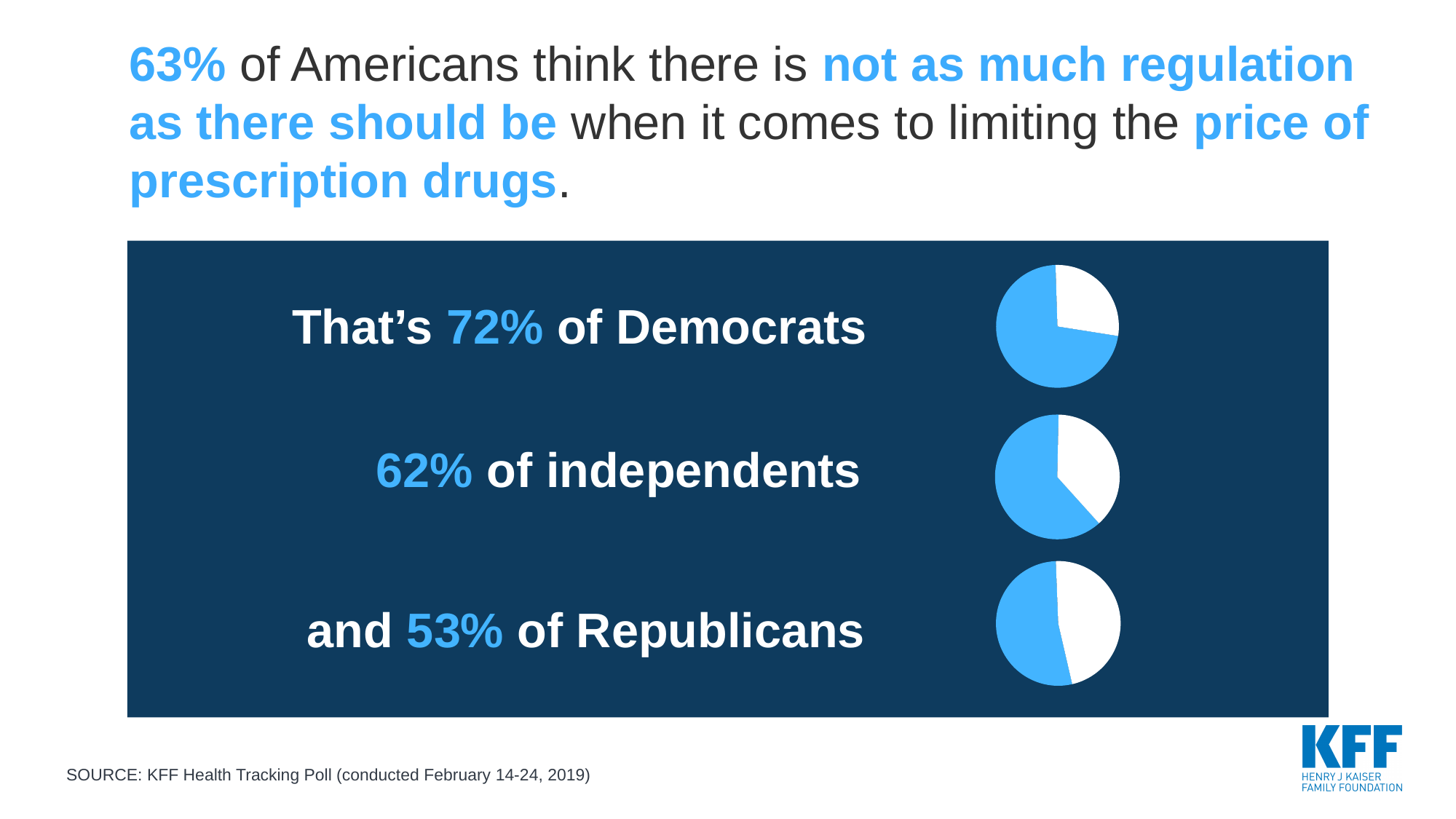
What kind of charts are shown on the dark panel of the slide? Pie charts What is the difference between the Democrats' share and the Republicans' share? 19 percentage points Which group has the smallest blue slice across the three pie charts? Republicans What percentage of all Americans does the slide headline say think there is not as much regulation as there should be? 63% What share of Democrats does the top pie chart's blue slice represent? 72% Which group has the largest blue slice across the three pie charts? Democrats What share of Republicans does the bottom pie chart's blue slice represent? 53% How many pie charts are shown on the slide? 3 Is the blue slice larger for independents or for Republicans? Independents What share of independents does the middle pie chart's blue slice represent? 62% What colour is used for the highlighted slice in each pie chart? Light blue What is the difference between the Democrats' share and the independents' share? 10 percentage points